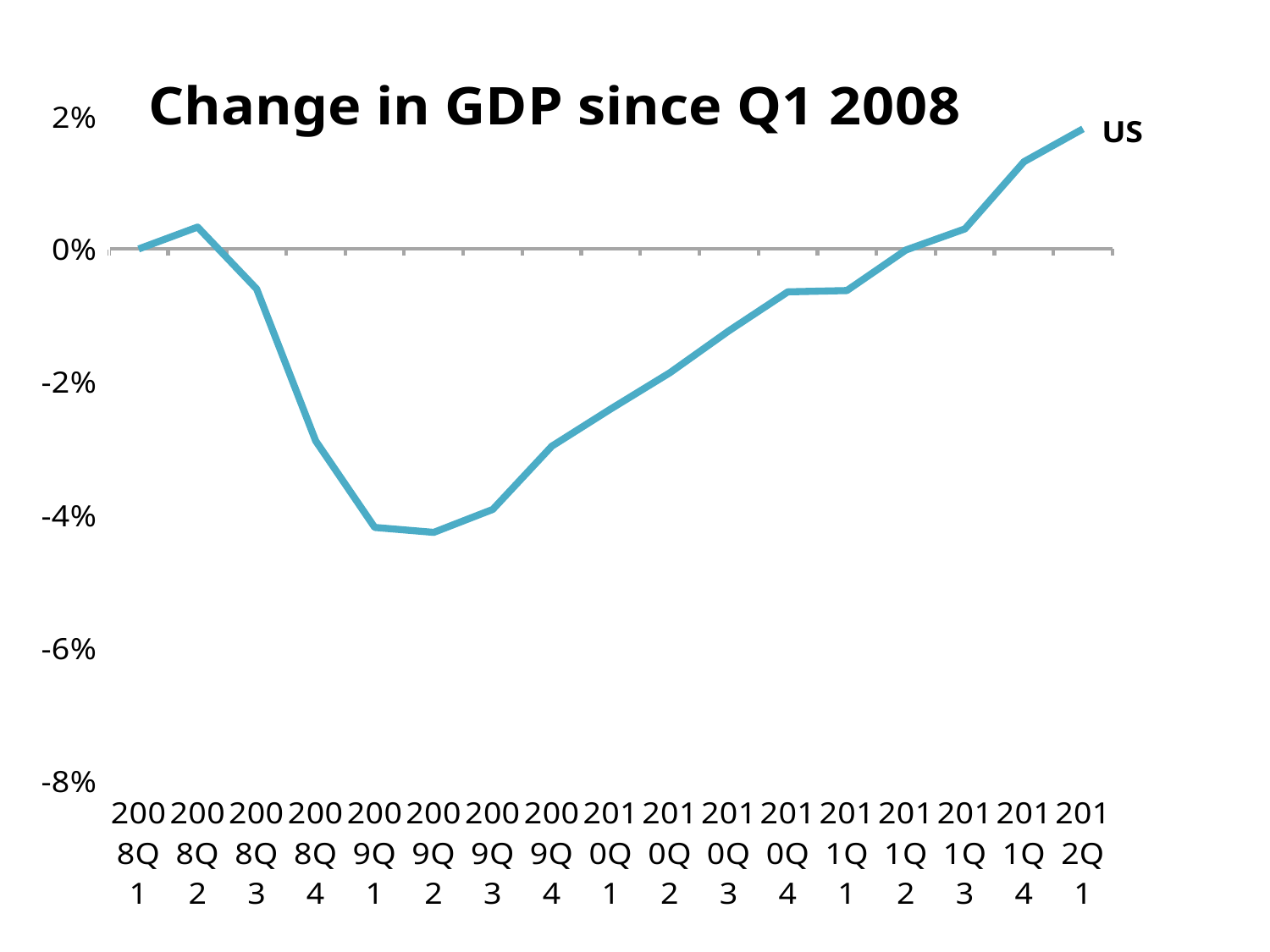
Is the value for 2011Q4 greater or less than 0%? greater Do the values rise or fall from 2009Q2 to 2012Q1? rise Is the value for 2009Q2 greater or less than -4%? less What kind of chart is shown on the slide? line chart How many quarters are plotted along the x axis? 17 How many series does the chart plot? 1 Is the value for 2008Q4 greater or less than -2%? less Which series is labelled on the chart? US Which is larger, the value for 2008Q2 or the value for 2008Q3? 2008Q2 Which quarter has the highest value on the chart? 2012Q1 What is the title of the chart? Change in GDP since Q1 2008